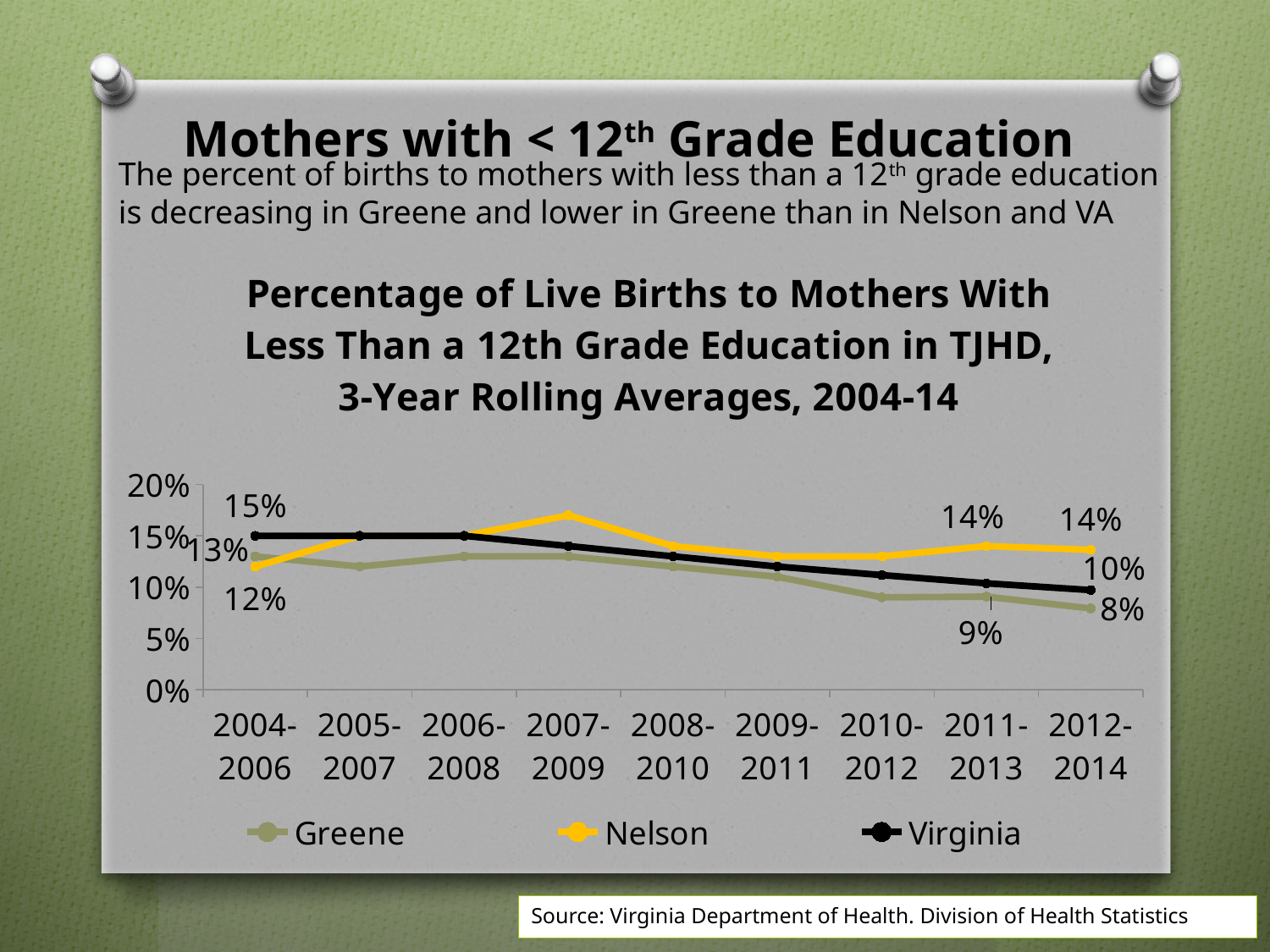
By how much did the Virginia value fall from 2004-2006 to 2012-2014? 5 percentage points What kind of chart is shown on the slide? Line chart Which series has the highest value in 2012-2014? Nelson How many 3-year periods are shown on the x axis? 9 What is the difference between the Nelson and Greene values in 2012-2014? 6 percentage points How many series does the legend list? 3 Does the Greene line rise or fall from 2004-2006 to 2012-2014? Fall What is the value for Nelson in 2012-2014? 14% What is the value for Virginia in 2004-2006? 15% What is the value for Greene in 2011-2013? 9% Is the value for Nelson in 2007-2009 greater or less than 15%? greater What is the value for Greene in 2012-2014? 8%